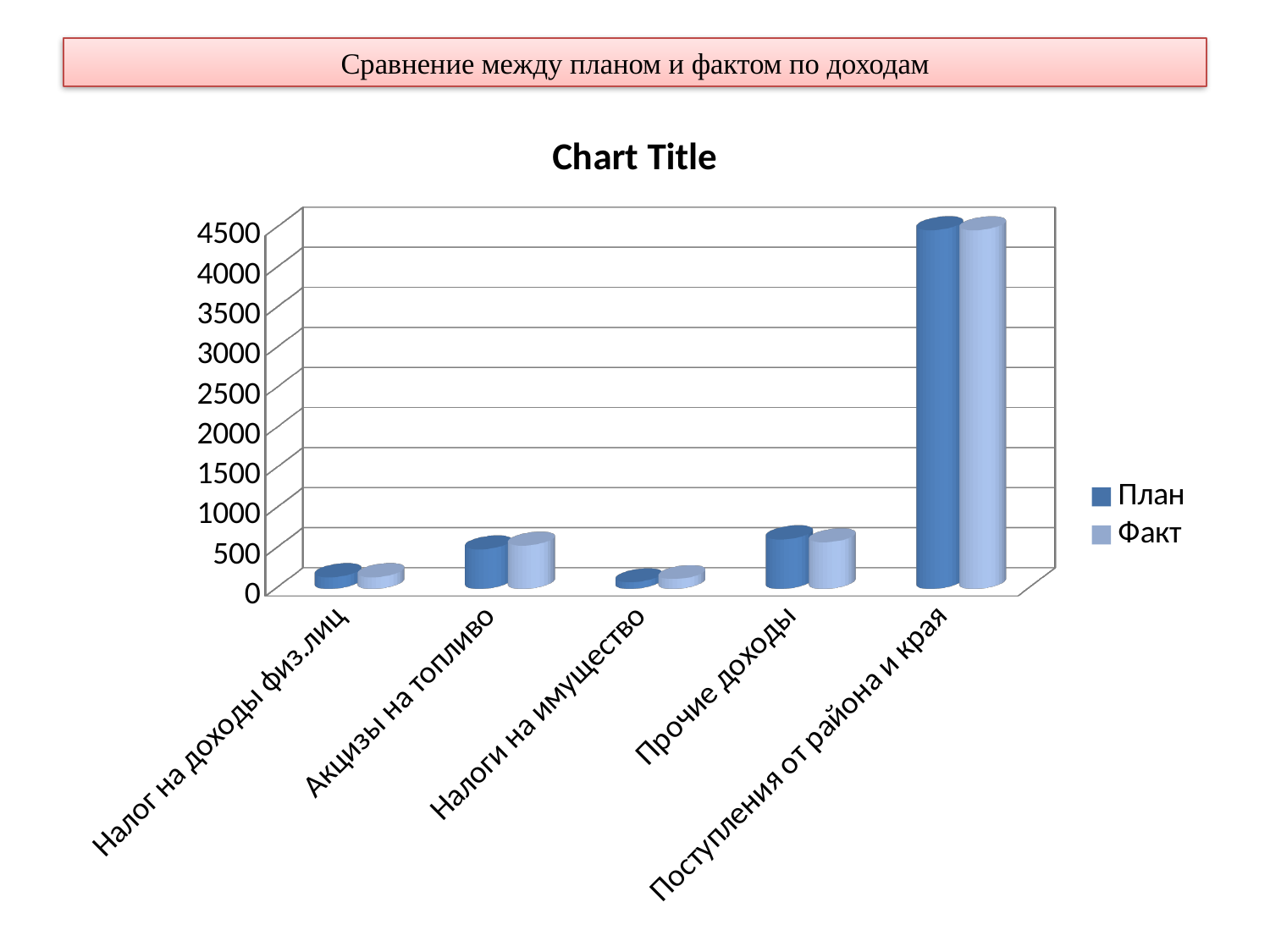
Is the План value for Налоги на имущество greater or less than 500? less How many series does the legend list? 2 Is the Факт value for Акцизы на топливо greater or less than 1000? less How many categories are shown on the x axis? 5 Which category has the highest План value? Поступления от района и края Which category has the highest Факт value? Поступления от района и края Is the План value for Прочие доходы greater or less than 1500? less What kind of chart is shown on the slide? bar chart Which is larger, the План value for Акцизы на топливо or the План value for Налог на доходы физ.лиц? Акцизы на топливо What are the two series named in the legend? План and Факт What is the title printed above the chart? Chart Title